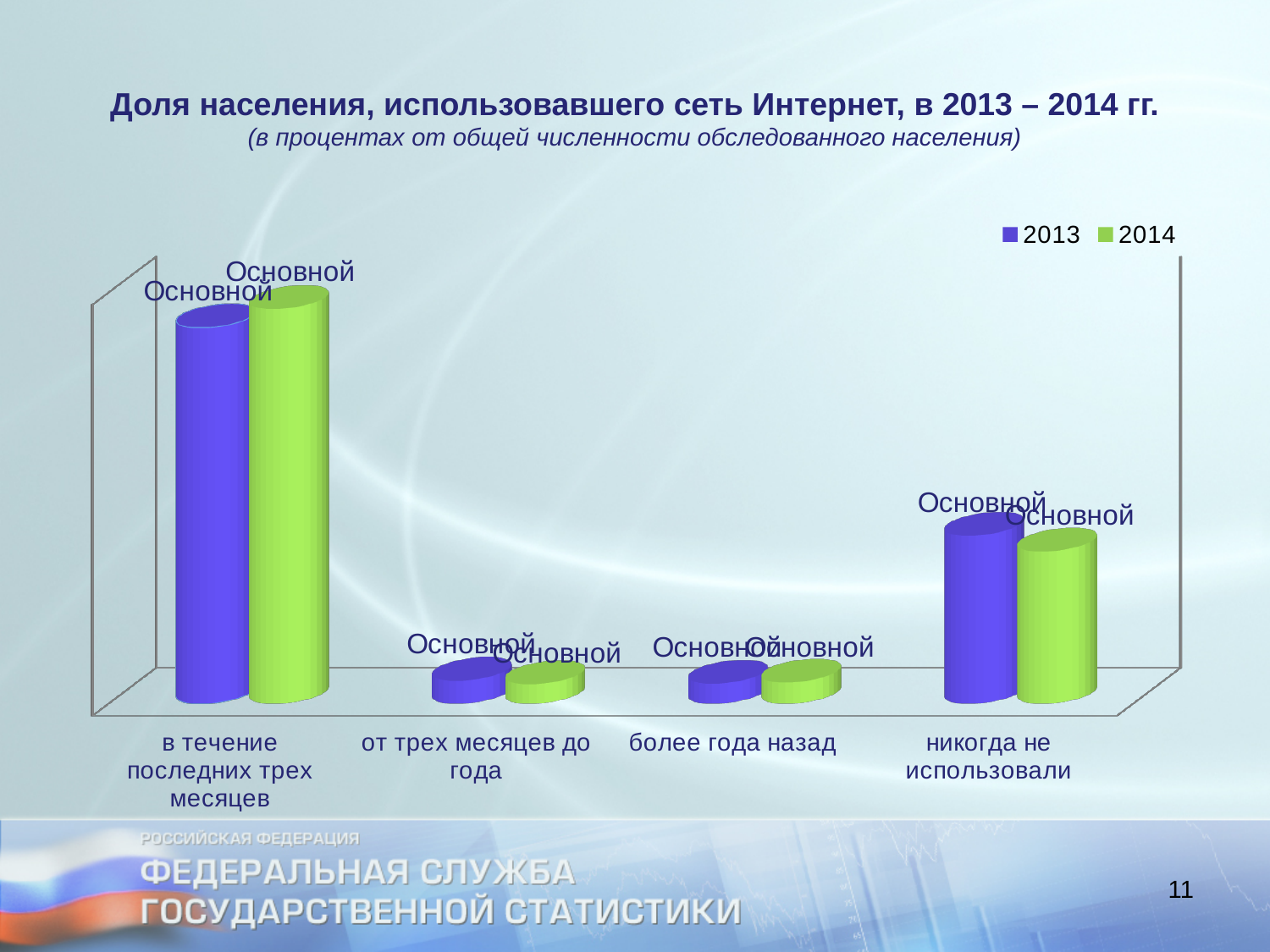
For the category 'никогда не использовали', which series has the larger value, 2013 or 2014? 2013 Which category has the highest value for the 2013 series? в течение последних трех месяцев Which category has the highest value for the 2014 series? в течение последних трех месяцев For the 2013 series, which is larger: 'в течение последних трех месяцев' or 'никогда не использовали'? в течение последних трех месяцев What kind of chart is shown on the slide? bar chart How many categories are shown along the x axis of the chart? 4 For the 2014 series, which is larger: 'никогда не использовали' or 'более года назад'? никогда не использовали What is the title of the chart on the slide? Доля населения, использовавшего сеть Интернет, в 2013 – 2014 гг. How many series does the chart's legend list? 2 Which category has the second-highest value for the 2013 series? никогда не использовали Which series are listed in the chart's legend? 2013 and 2014